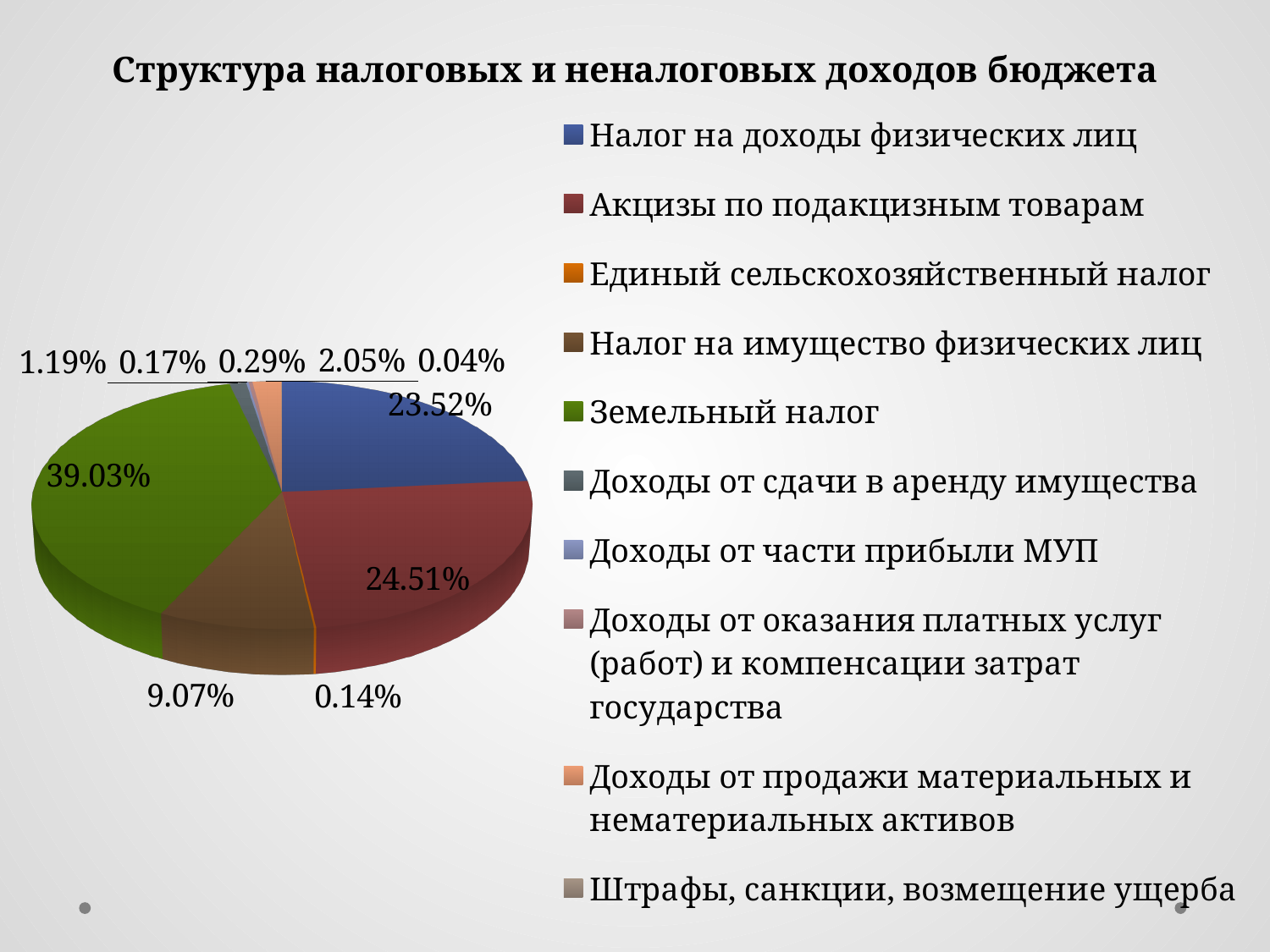
What share of the pie is Земельный налог? 39.03% What share of the pie is Налог на доходы физических лиц? 23.52% What is the title of the chart? Структура налоговых и неналоговых доходов бюджета Which is larger: Акцизы по подакцизным товарам or Налог на доходы физических лиц? Акцизы по подакцизным товарам Which category has the largest share of the pie? Земельный налог What share of the pie is Акцизы по подакцизным товарам? 24.51% What is the difference between the shares of Земельный налог and Акцизы по подакцизным товарам? 14.52% What share of the pie is Налог на имущество физических лиц? 9.07% What kind of chart is shown on the slide? pie chart What is the smallest percentage shown on the chart? 0.04% How many categories does the legend list? 10 What share of the pie is Единый сельскохозяйственный налог? 0.14%